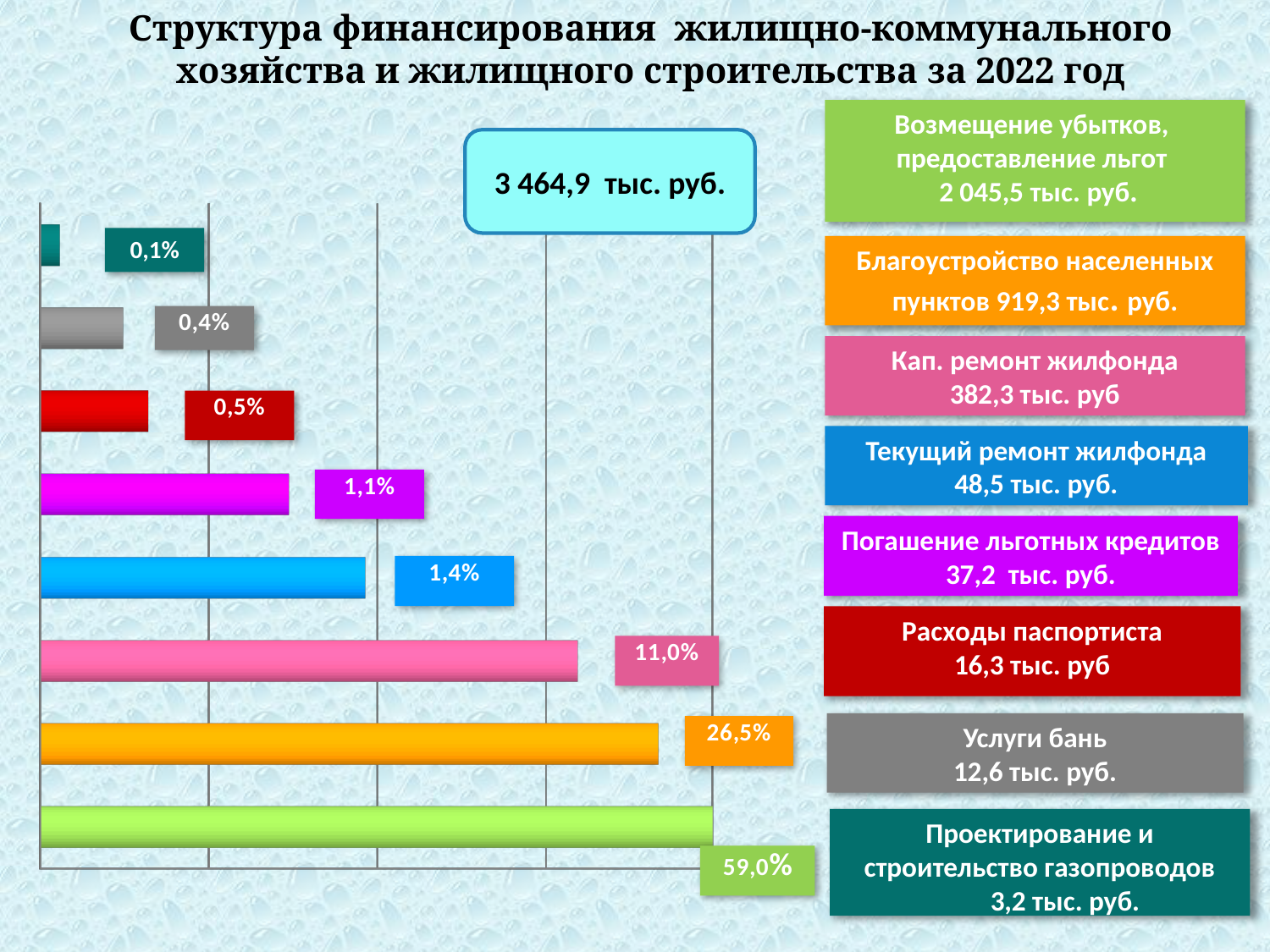
Which category has the smallest share in the chart? Проектирование и строительство газопроводов Which category has the largest share in the chart? Возмещение убытков, предоставление льгот Which is larger: the share for "Погашение льготных кредитов" or the share for "Расходы паспортиста"? Погашение льготных кредитов What percentage share is shown for "Благоустройство населенных пунктов" (the orange bar)? 26,5% What type of chart is shown on the slide? bar chart What is the difference in percentage points between the green bar (59,0%) and the orange bar (26,5%)? 32,5 What percentage share is shown for "Возмещение убытков, предоставление льгот" (the green bar)? 59,0% What percentage share is shown for "Кап. ремонт жилфонда" (the pink bar)? 11,0% What total amount of financing is shown in the box above the chart? 3 464,9 тыс. руб. What percentage share is shown for "Услуги бань" (the gray bar)? 0,4% What percentage share is shown for "Текущий ремонт жилфонда" (the blue bar)? 1,4% How many bars are plotted in the chart? 8